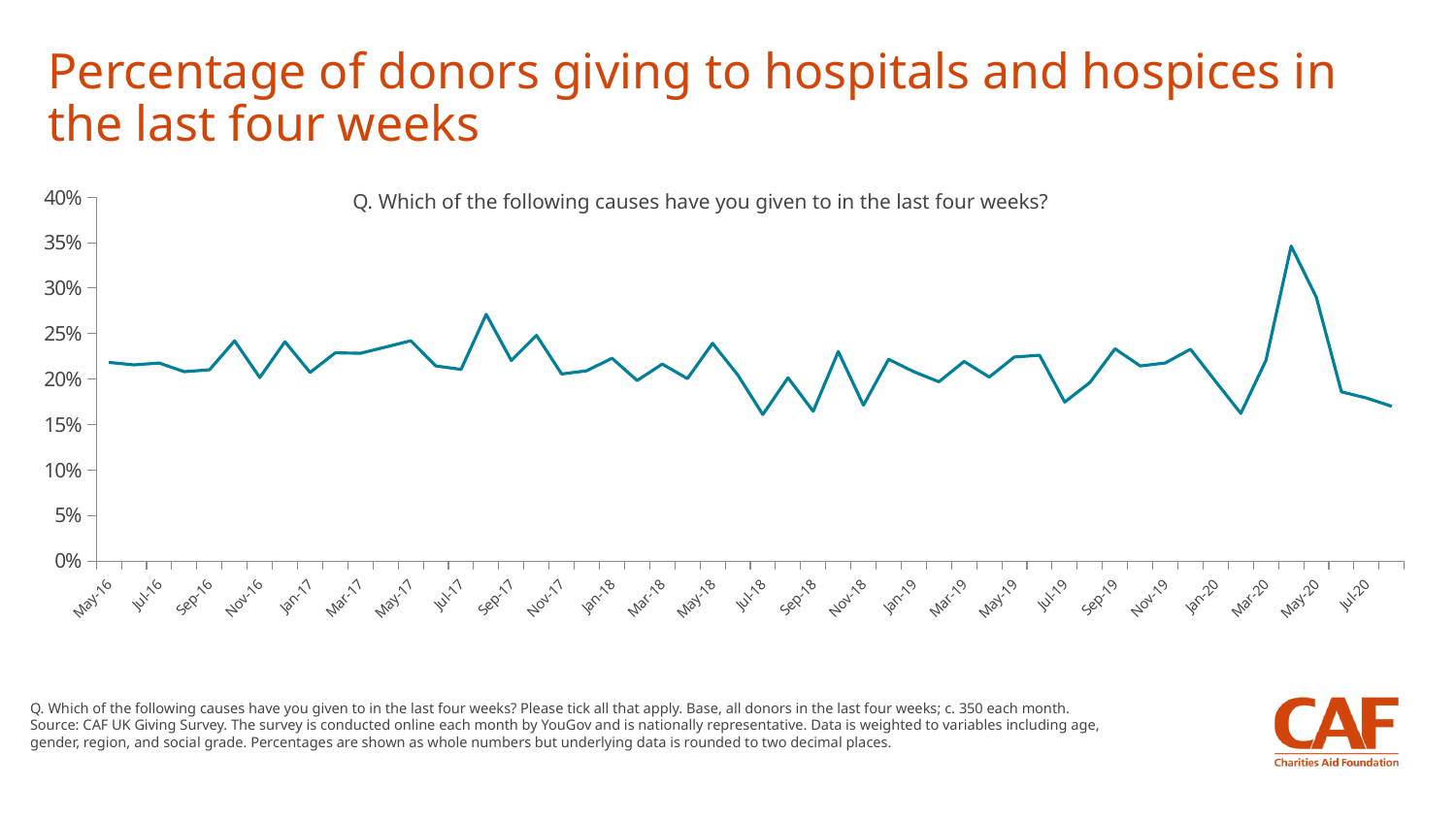
Which is larger, the value for Nov-17 or the value for Jul-18? Nov-17 Is the value for Jul-18 greater or less than 20%? less What is the title of the chart on the slide? Percentage of donors giving to hospitals and hospices in the last four weeks In which year does the line reach its highest peak? 2020 Is the value for May-20 greater or less than 25%? greater Is the highest point on the line greater or less than 30%? greater What is the highest value shown on the vertical axis? 40% What kind of chart is shown on the slide? line chart Which is larger, the value for May-16 or the value for Jul-20? May-16